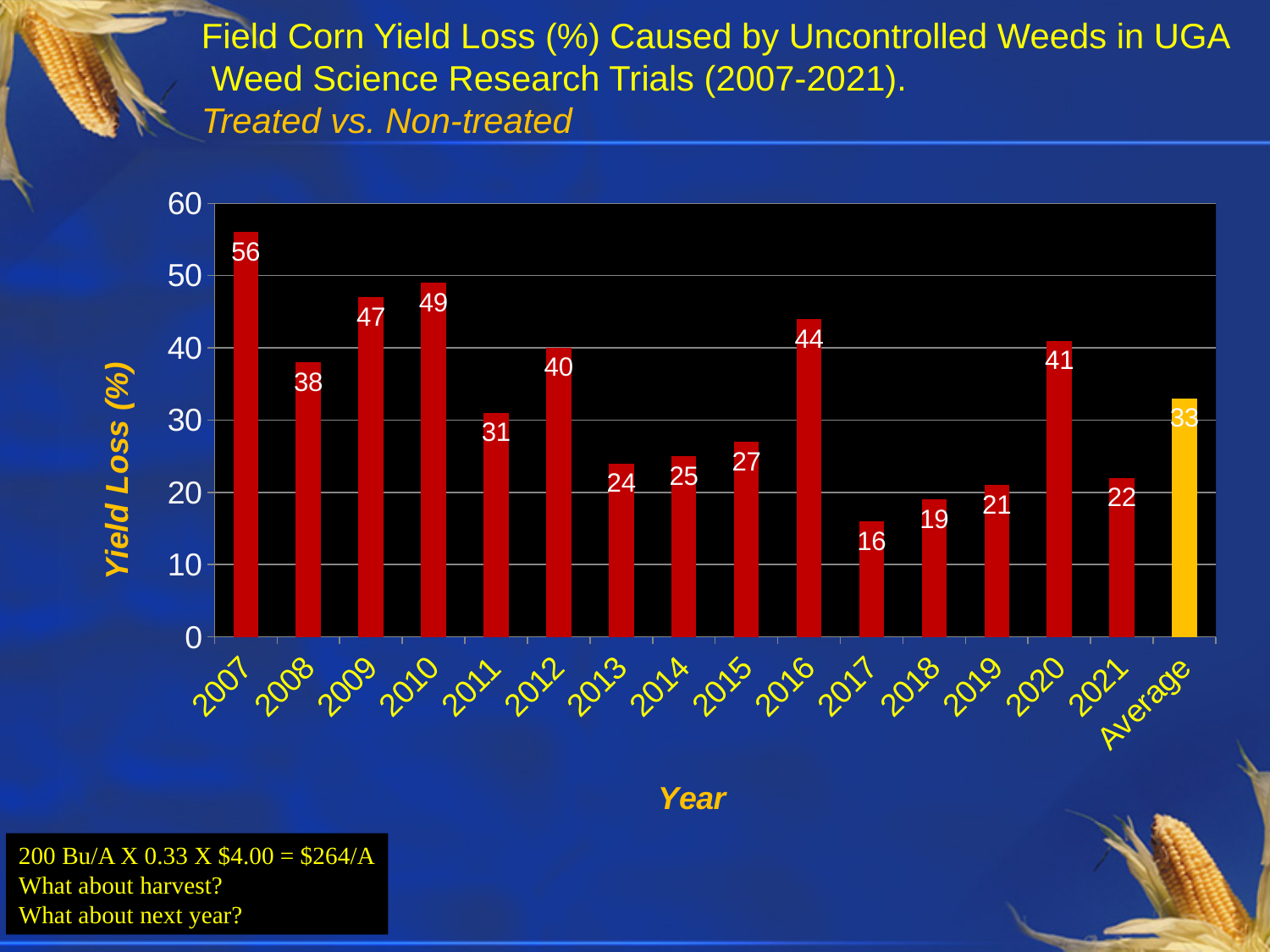
How many bars are plotted in the chart, including the Average bar? 16 What is the difference between the yield loss in 2007 and in 2017? 40 What is the yield loss value for 2017? 16 What is the label of the y axis? Yield Loss (%) Is the value for 2010 greater or less than 40? greater What kind of chart is shown on the slide? Bar chart Which year has the highest yield loss? 2007 Which bar is shown in a different colour (yellow) from the others? Average Which year has a larger yield loss, 2016 or 2020? 2016 What is the value shown for the Average bar? 33 What is the yield loss value for 2007? 56 Which year has the lowest yield loss? 2017